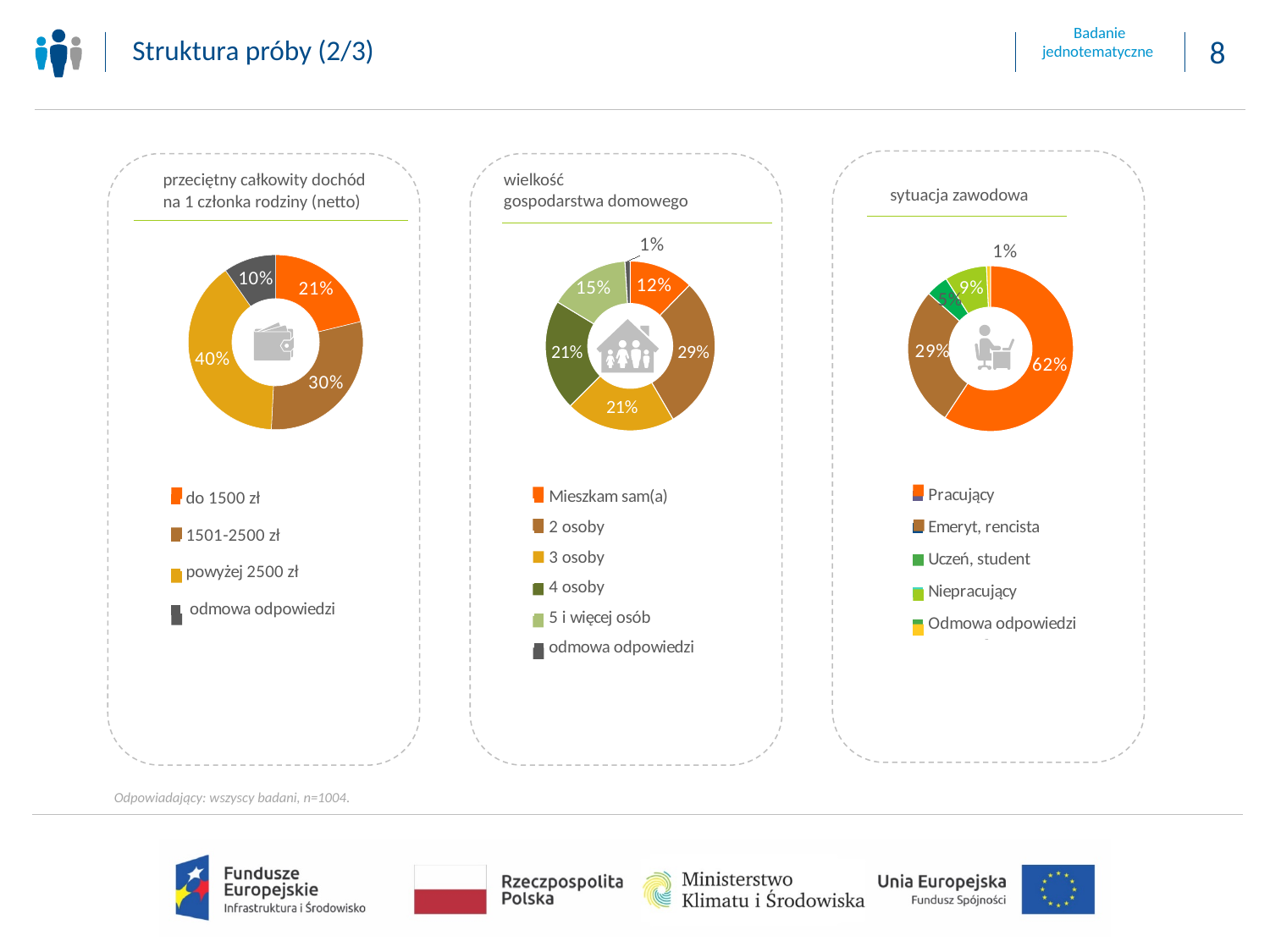
In the chart titled 'przeciętny całkowity dochód na 1 członka rodziny (netto)', what share is 'powyżej 2500 zł'? 40% In the chart titled 'przeciętny całkowity dochód na 1 członka rodziny (netto)', what is the difference between the shares for '1501-2500 zł' and 'do 1500 zł'? 9 percentage points In the chart titled 'wielkość gospodarstwa domowego', which is larger: 'Mieszkam sam(a)' or '5 i więcej osób'? 5 i więcej osób How many donut charts are shown on the slide? 3 How many categories does the legend of the 'wielkość gospodarstwa domowego' chart list? 6 In the chart titled 'sytuacja zawodowa', what share is 'Emeryt, rencista'? 29% What kind of chart is used in the 'wielkość gospodarstwa domowego' panel? Donut (pie) chart In the chart titled 'wielkość gospodarstwa domowego', which category has the largest share? 2 osoby In the chart titled 'przeciętny całkowity dochód na 1 członka rodziny (netto)', which category has the smallest share? odmowa odpowiedzi In the chart titled 'sytuacja zawodowa', what is the difference between the shares for 'Pracujący' and 'Emeryt, rencista'? 33 percentage points In the chart titled 'wielkość gospodarstwa domowego', what share is '2 osoby'? 29% In the chart titled 'sytuacja zawodowa', what share is 'Pracujący'? 62%